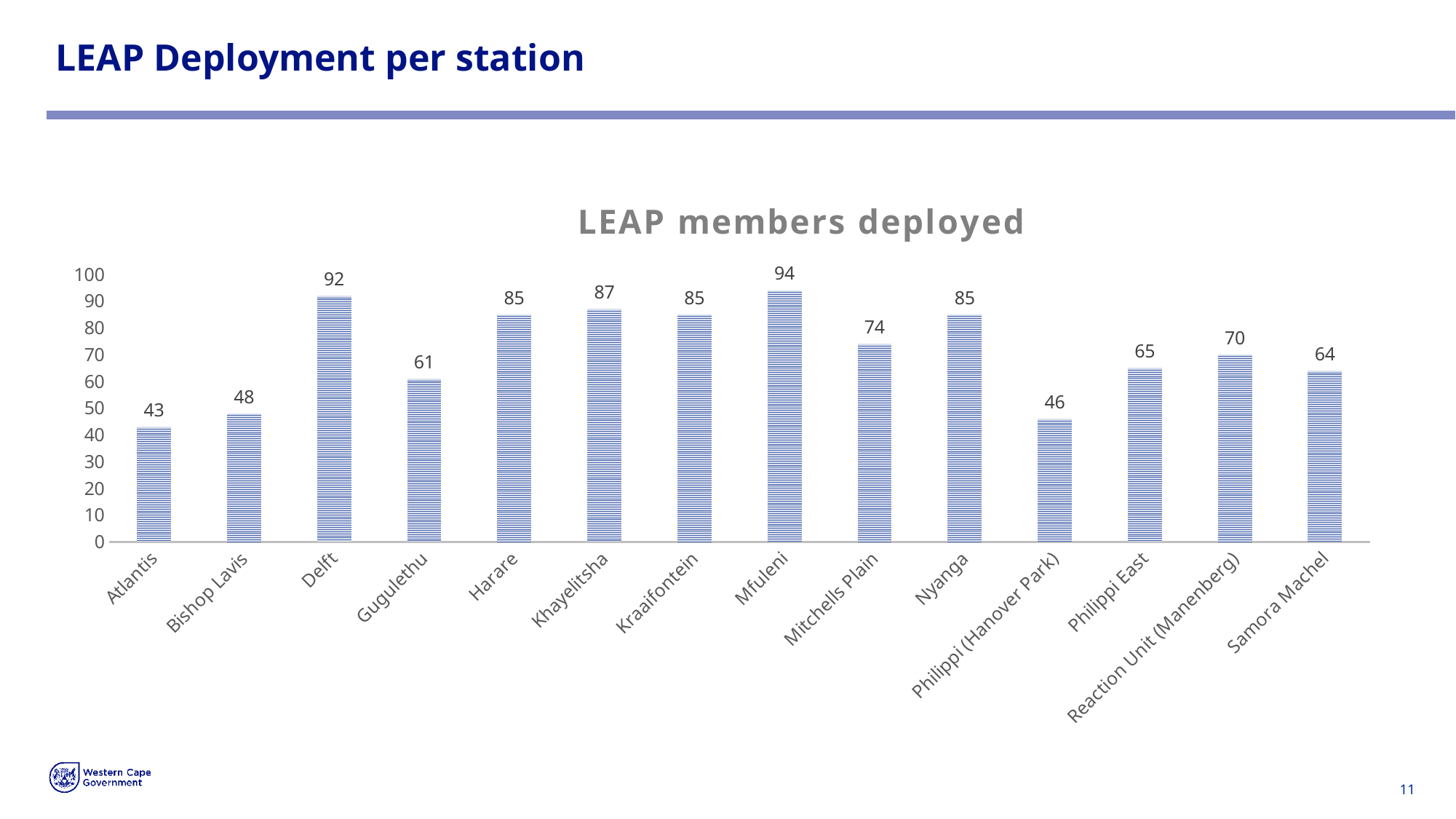
How many LEAP members were deployed at Delft? 92 What is the difference between the values for Khayelitsha and Gugulethu? 26 What kind of chart is shown on the slide? bar chart How many stations are shown on the chart? 14 Is the value for Bishop Lavis greater or less than 60? less What is the value for Mitchells Plain? 74 What is the title of the chart? LEAP members deployed What is the difference between the values for Mfuleni and Atlantis? 51 Which station has the lowest number of LEAP members deployed? Atlantis Which has a larger value, Philippi East or Samora Machel? Philippi East Which station has the highest number of LEAP members deployed? Mfuleni How many LEAP members were deployed at Reaction Unit (Manenberg)? 70